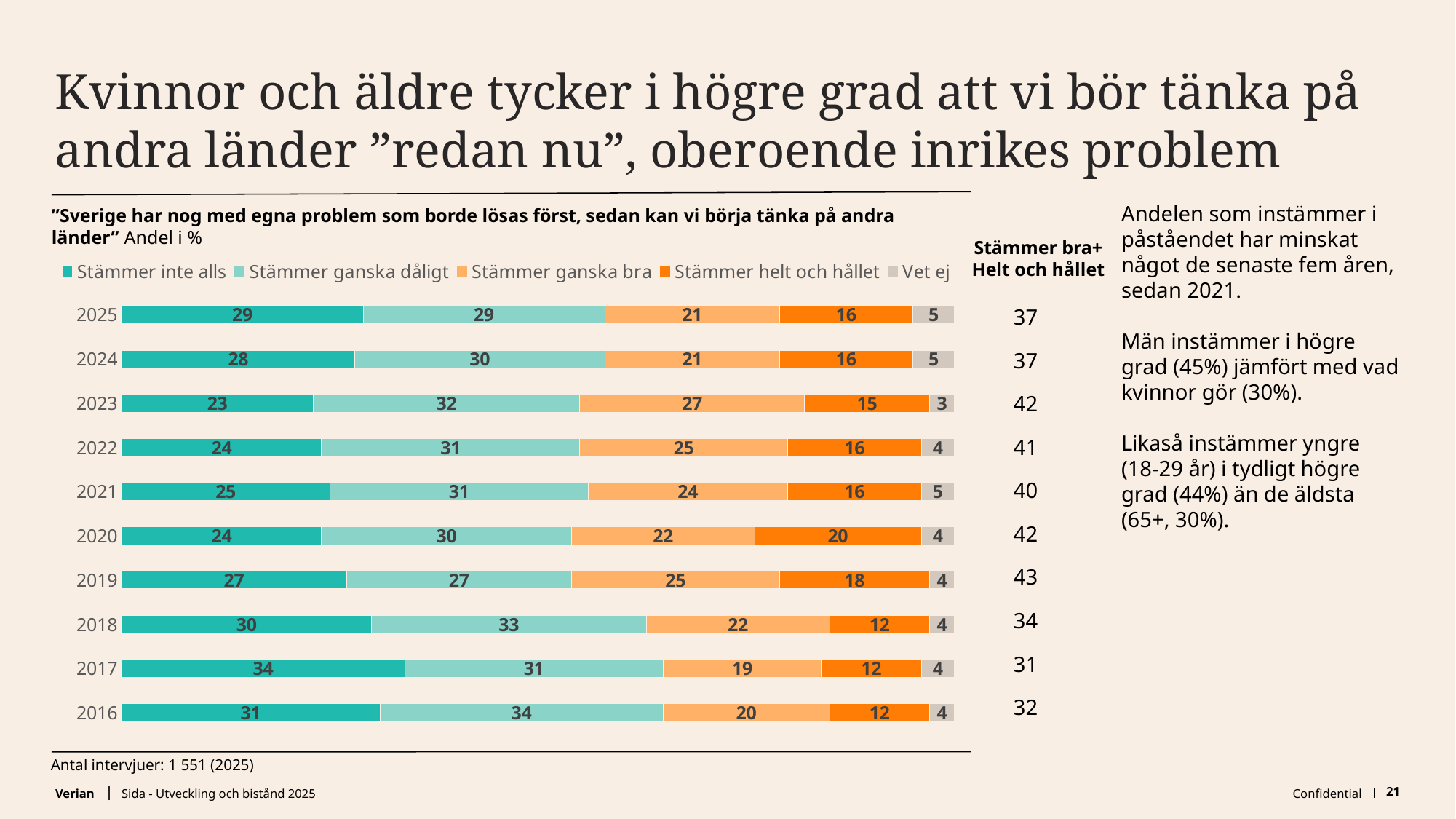
In which year is the value for "Stämmer inte alls" lowest? 2023 What is the value for "Stämmer inte alls" in 2025? 29 What is the value for "Stämmer ganska bra" in 2023? 27 What kind of chart is shown on the slide? Stacked bar chart What is the difference between the "Stämmer inte alls" values for 2017 and 2023? 11 In which year is the value for "Stämmer inte alls" highest? 2017 How many series does the legend list? 5 What is the value for "Vet ej" in 2023? 3 Which is larger, the "Stämmer ganska dåligt" value for 2016 or for 2019? 2016 What is the value for "Stämmer helt och hållet" in 2020? 20 In which year is the value for "Stämmer helt och hållet" highest? 2020 How many years are shown in the chart? 10